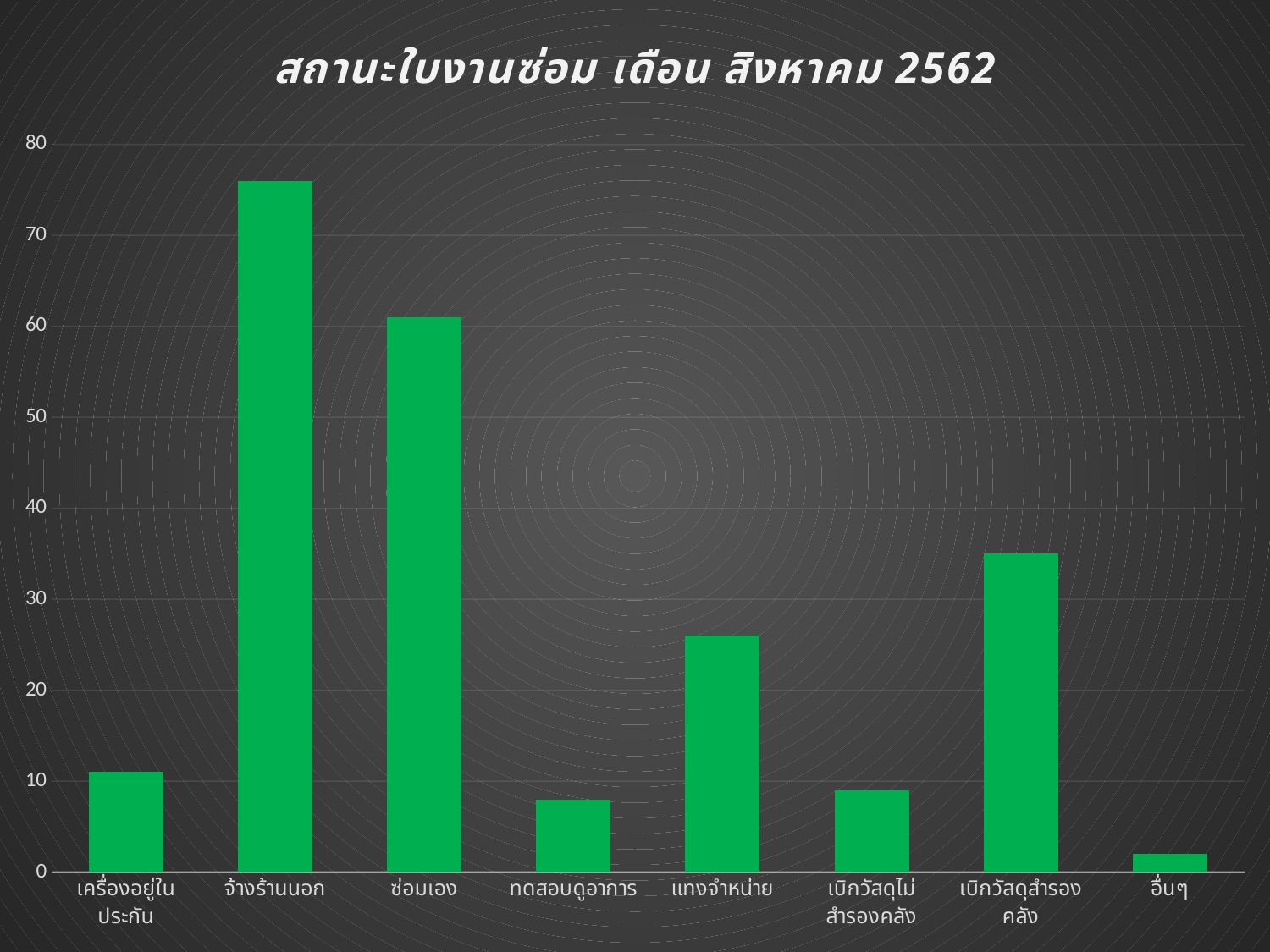
Is the value for เบิกวัสดุสำรองคลัง greater or less than 40? less Is the value for จ้างร้านนอก greater or less than 70? greater Which category has the highest value in the chart? จ้างร้านนอก Is the value for ซ่อมเอง greater or less than 50? greater Which is larger, the value for ซ่อมเอง or the value for แทงจำหน่าย? ซ่อมเอง Which category has the lowest value in the chart? อื่นๆ How many categories are shown on the x axis of the chart? 8 What is the title of the chart? สถานะใบงานซ่อม เดือน สิงหาคม 2562 Which is larger, the value for เบิกวัสดุสำรองคลัง or the value for เครื่องอยู่ในประกัน? เบิกวัสดุสำรองคลัง What kind of chart is shown on the slide? bar chart